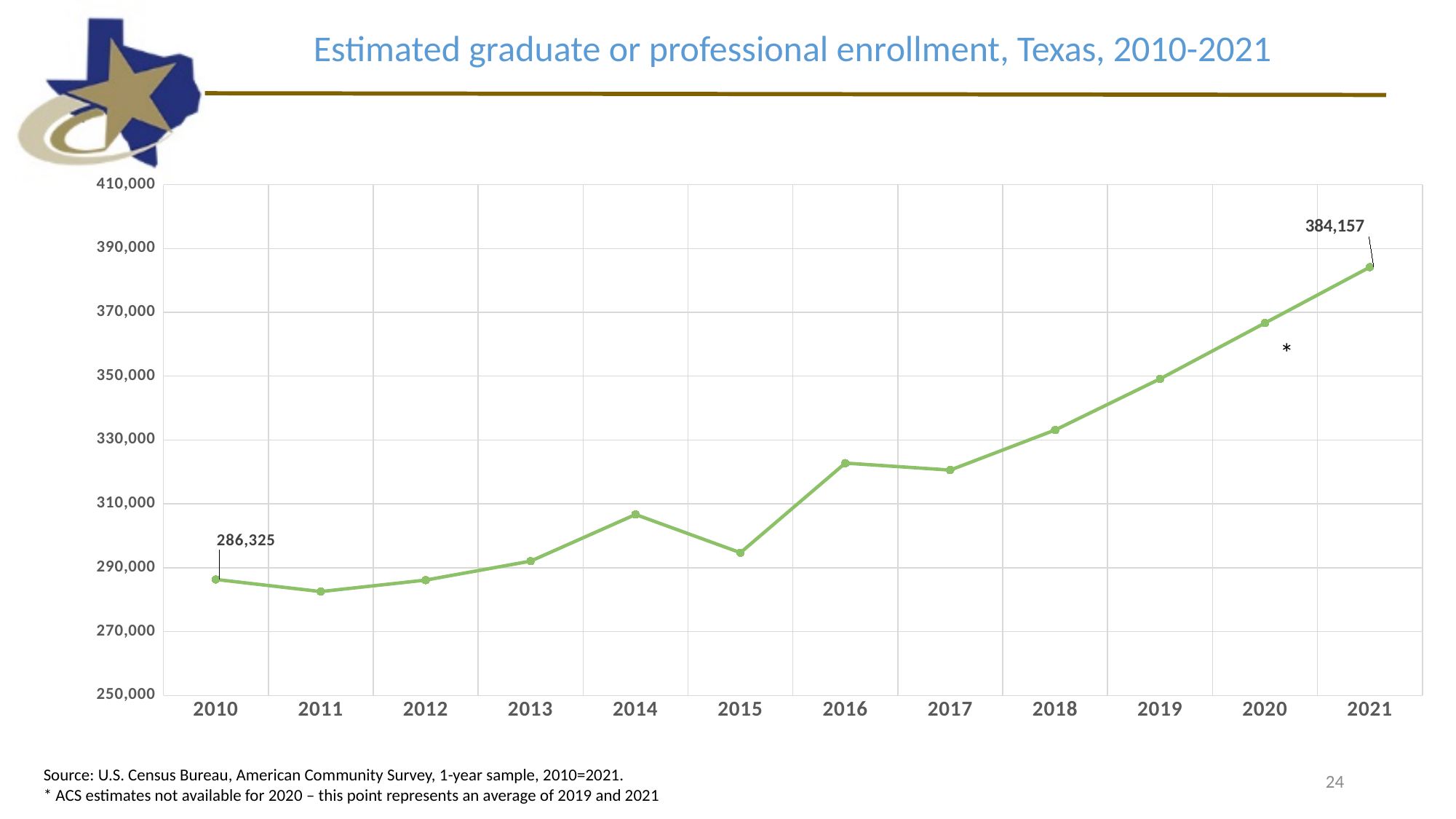
Is the value for 2015 greater or less than 290,000? greater How many years are plotted on the chart? 12 Which year has the highest estimated enrollment? 2021 Is the value for 2018 greater or less than 330,000? greater Which year has the larger enrollment value, 2016 or 2017? 2016 What kind of chart is shown on the slide? line chart What is the estimated graduate or professional enrollment in Texas for 2010? 286,325 Is the value for 2014 greater or less than 310,000? less What is the difference between the 2021 and 2010 enrollment values? 97,832 Overall, does the enrollment rise or fall from 2010 to 2021? rise Which year has the lowest estimated enrollment? 2011 What is the estimated graduate or professional enrollment in Texas for 2021? 384,157